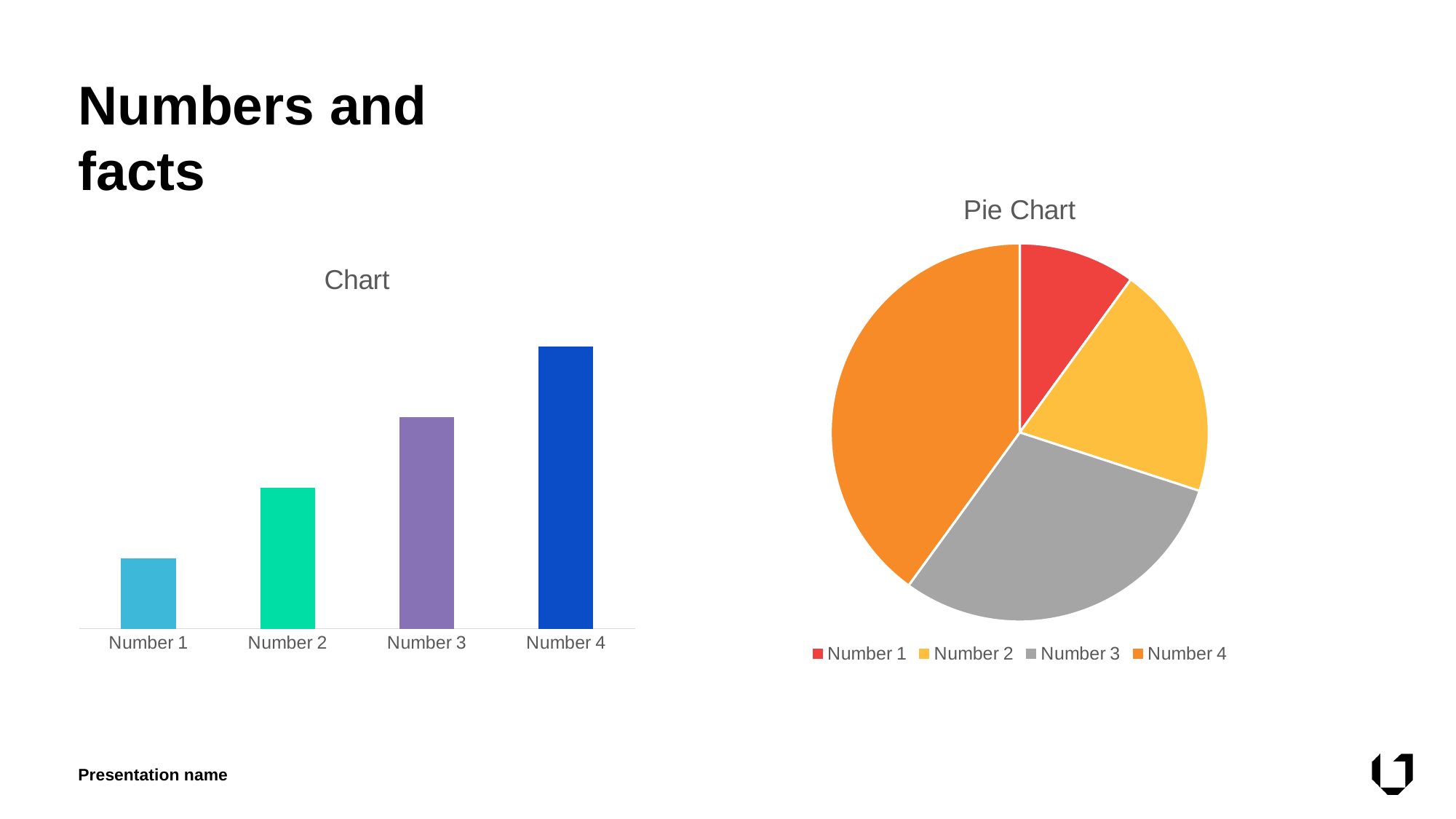
In the chart titled "Chart", which category has the lowest bar? Number 1 In the chart titled "Pie Chart", what colour is the slice for Number 3? grey What kind of chart is the chart titled "Pie Chart" on the right of the slide? pie chart In the chart titled "Chart", which is larger, the bar for Number 2 or the bar for Number 3? Number 3 How many entries does the legend of the chart titled "Pie Chart" list? 4 How many categories are shown in the chart titled "Chart"? 4 What kind of chart is the chart titled "Chart" on the left of the slide? bar chart In the chart titled "Pie Chart", which category has the smallest slice? Number 1 In the chart titled "Pie Chart", which category has the largest slice? Number 4 In the chart titled "Pie Chart", which slice is larger, Number 2 or Number 3? Number 3 In the chart titled "Chart", which category has the highest bar? Number 4 In the chart titled "Chart", do the bars rise or fall from Number 1 to Number 4? rise